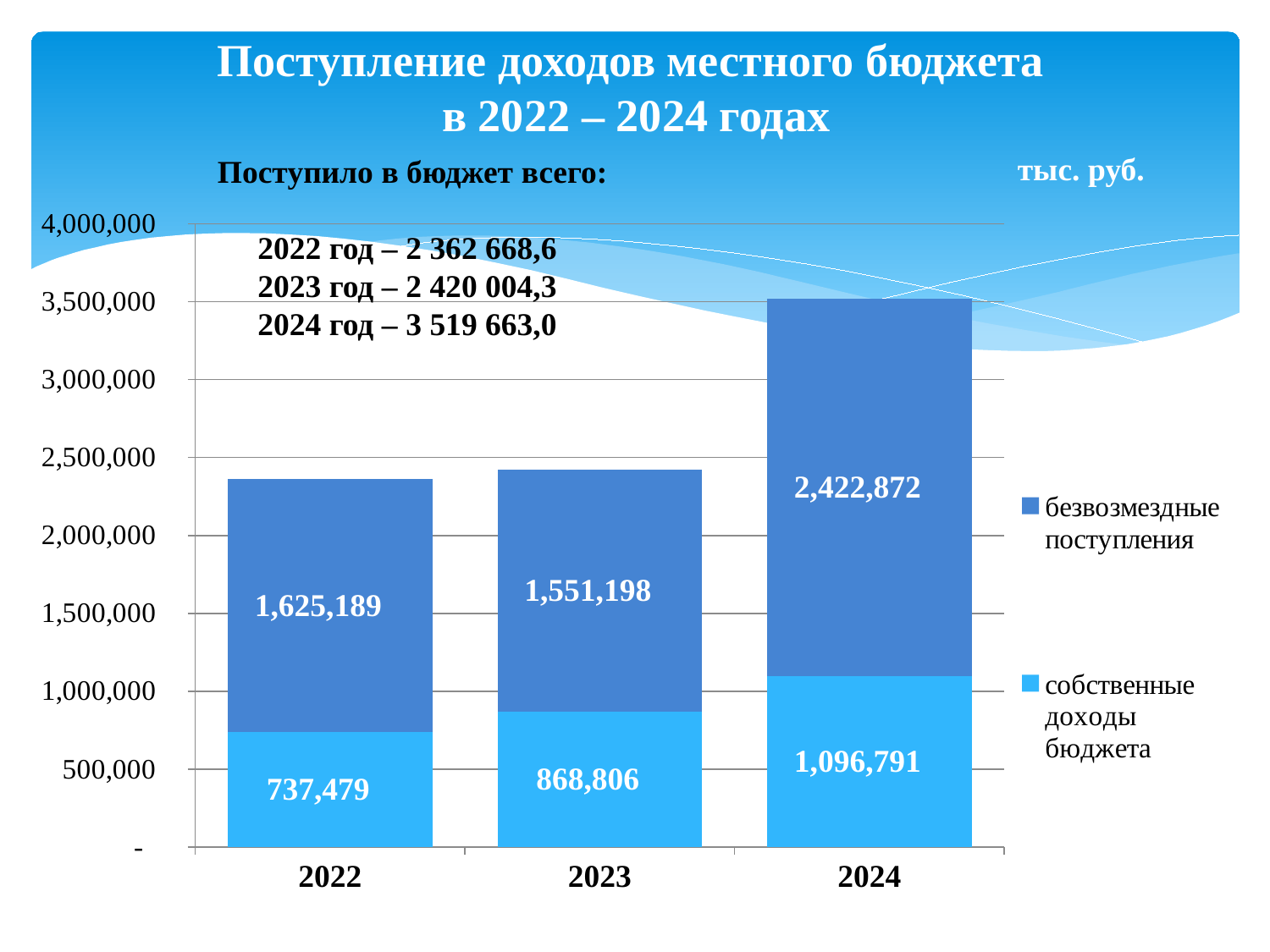
In which year is the value of собственные доходы бюджета the highest? 2024 Which is larger in 2023: безвозмездные поступления or собственные доходы бюджета? безвозмездные поступления What is the value of безвозмездные поступления for 2023? 1,551,198 What kind of chart is shown on the slide? stacked bar chart What is the total of the stacked bar for 2024 (sum of the two data labels)? 3,519,663 What is the difference between собственные доходы бюджета in 2024 and in 2022? 359,312 What is the value of безвозмездные поступления for 2024? 2,422,872 In which year is the value of безвозмездные поступления the lowest? 2023 How many series does the legend list? 2 How many years are shown on the x axis? 3 What is the value of собственные доходы бюджета for 2022? 737,479 Is the total height of the 2024 stacked bar greater or less than 3,000,000? greater